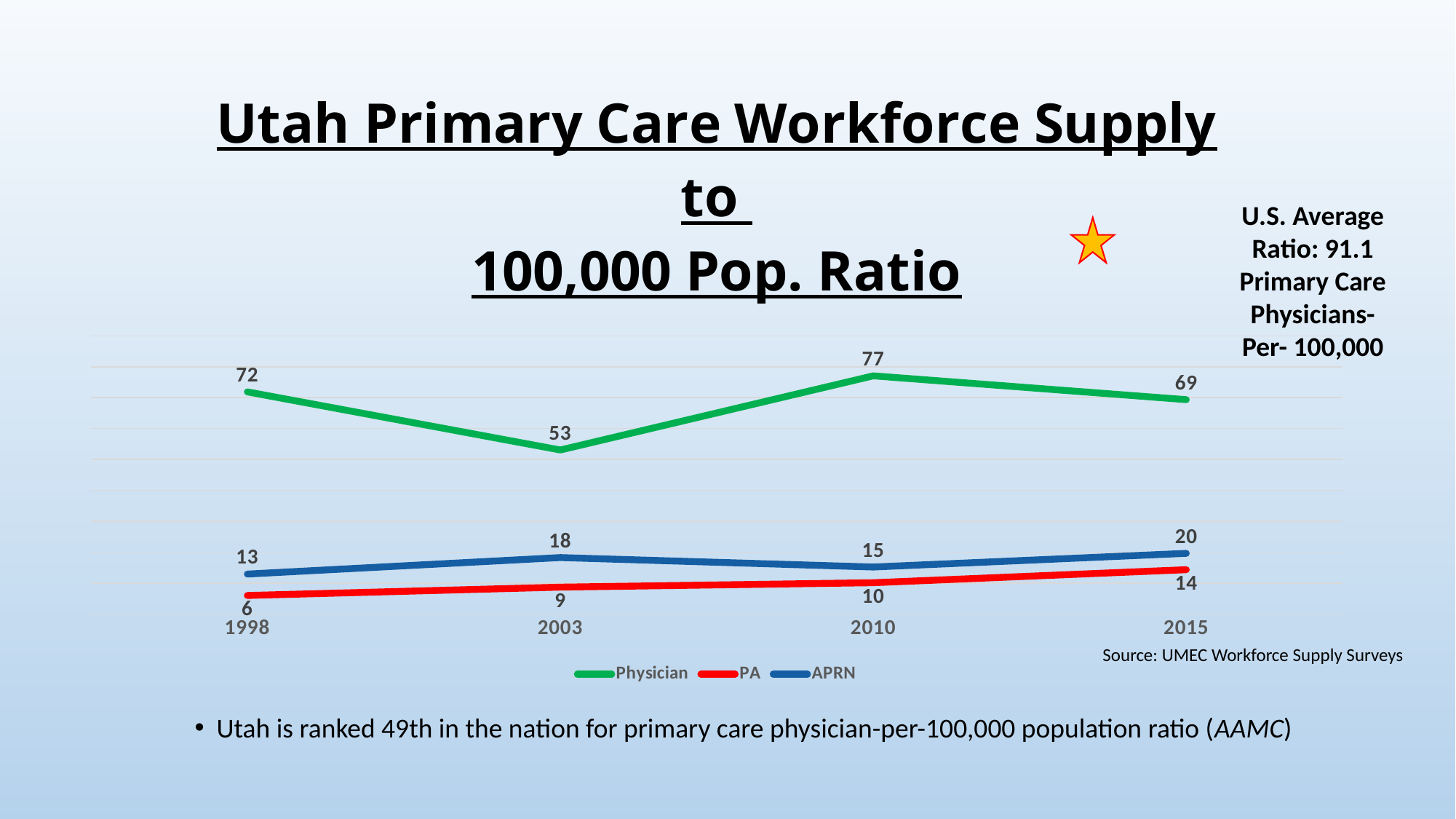
What kind of chart is shown? line chart How many series does the legend list? 3 Which is larger in 2015, the APRN value or the PA value? APRN In which year is the Physician value lowest? 2003 Does the PA series rise or fall from 1998 to 2015? rise What is the APRN value in 2003? 18 What is the Physician value in 2010? 77 Which colour is used for the Physician series? green What is the difference between the Physician values in 2010 and 2003? 24 What is the PA value in 1998? 6 How many years are shown on the x axis? 4 In which year is the Physician value highest? 2010